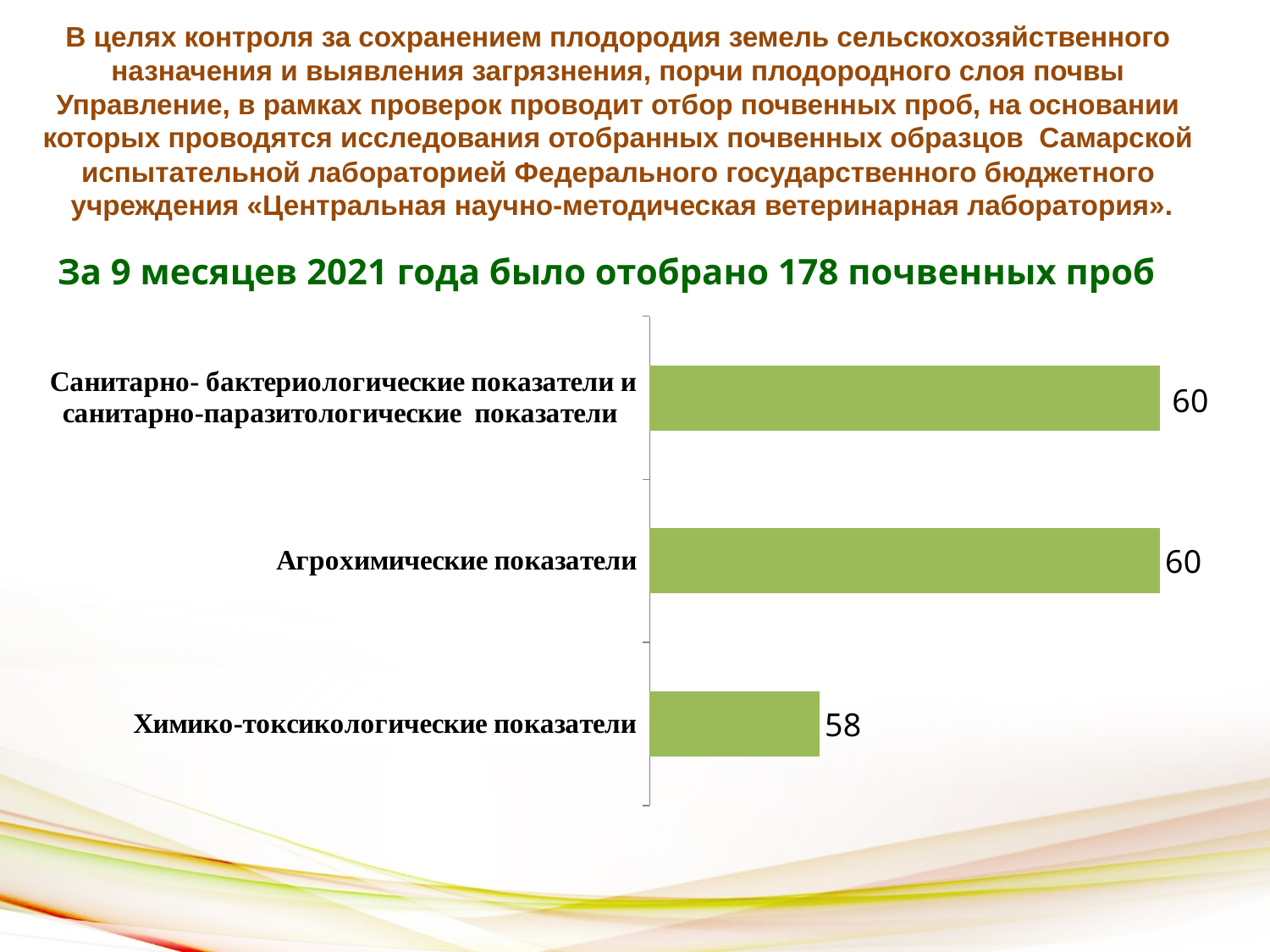
What kind of chart is shown on the slide? Bar chart How many categories are shown in the chart? 3 According to the heading above the chart, how many soil samples were taken in 9 months of 2021? 178 What is the difference between the values for Агрохимические показатели and Химико-токсикологические показатели? 2 What is the value for Агрохимические показатели? 60 Are the values for Агрохимические показатели and Санитарно-бактериологические показатели и санитарно-паразитологические показатели equal? Yes What is the value for Санитарно-бактериологические показатели и санитарно-паразитологические показатели? 60 Which is larger: the value for Санитарно-бактериологические показатели и санитарно-паразитологические показатели or the value for Химико-токсикологические показатели? Санитарно-бактериологические показатели и санитарно-паразитологические показатели What is the total of the three values shown in the chart? 178 Which category has the lowest value? Химико-токсикологические показатели What is the value for Химико-токсикологические показатели? 58 What colour are the bars in the chart? Green